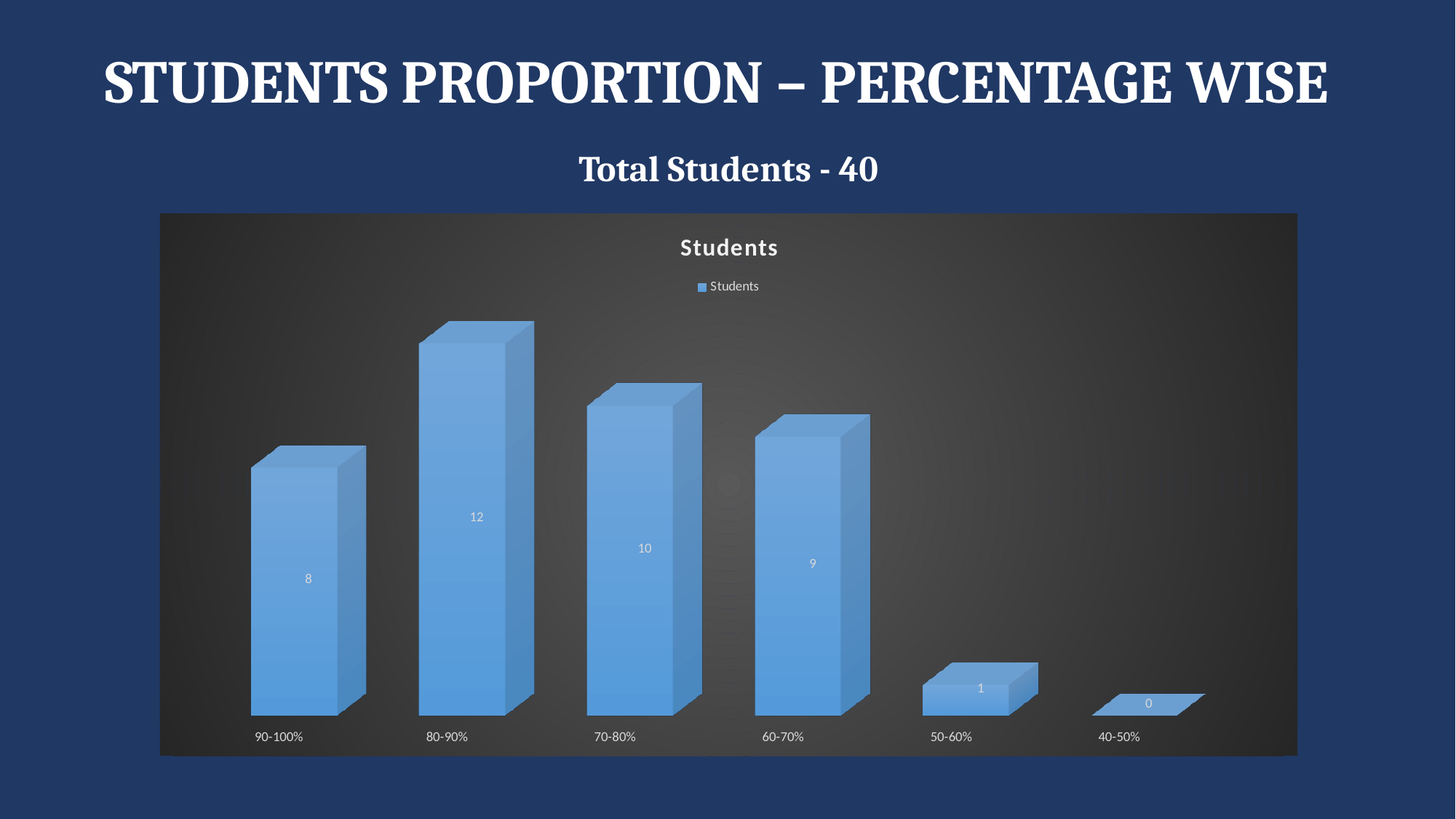
How many categories are shown on the x axis? 6 How many students are in the 80-90% category? 12 What is the total of the values for the 70-80% and 60-70% categories? 19 How many students are in the 50-60% category? 1 What kind of chart is shown on the slide? bar chart What is the value for the 90-100% category? 8 Which category has the lowest number of students? 40-50% Which category has the highest number of students? 80-90% Which is larger, the value for 60-70% or the value for 90-100%? 60-70% What is the difference between the 80-90% and 70-80% categories? 2 How many series does the legend list? 1 What is the title of the chart? Students